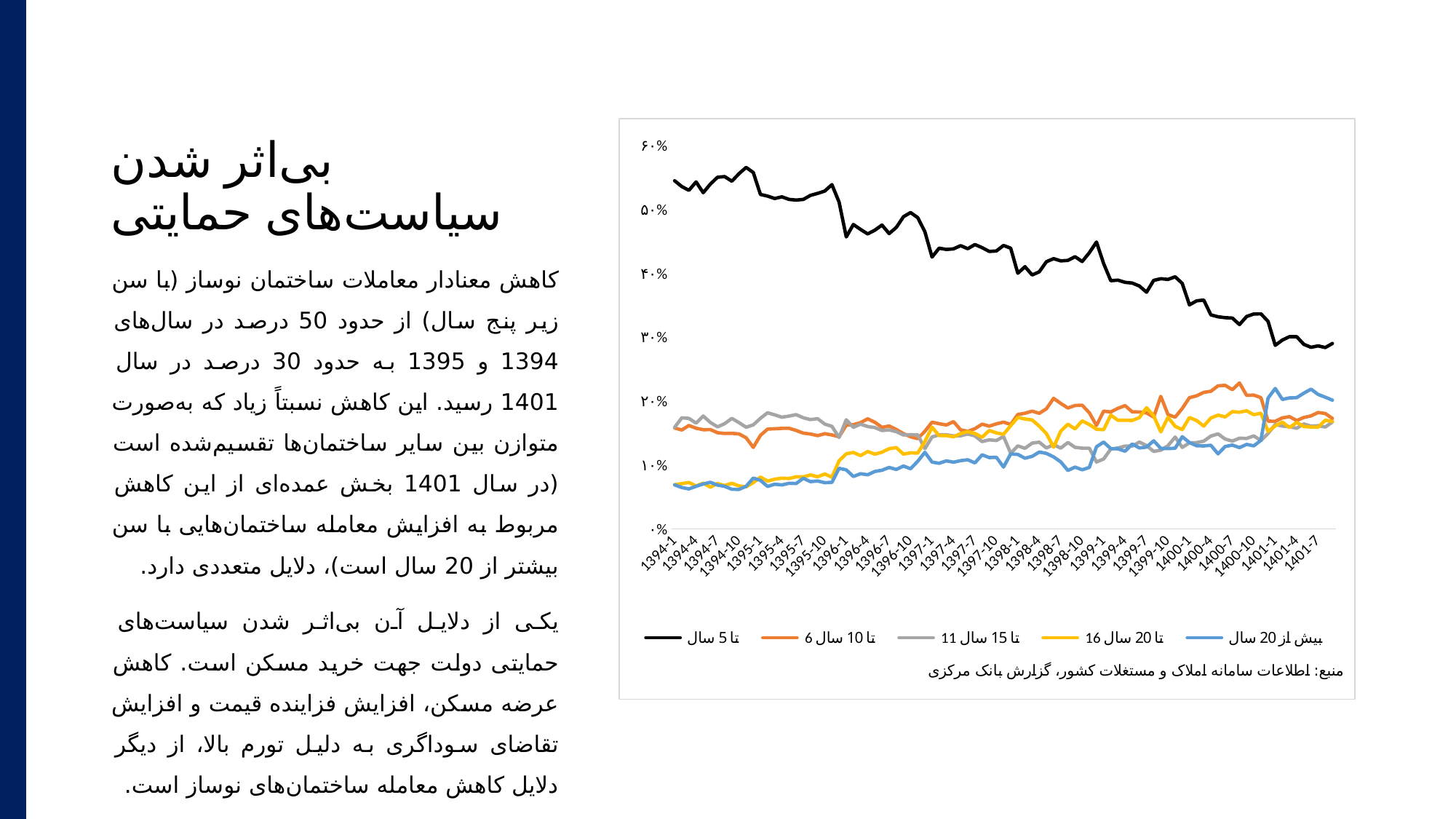
What colour is the line for the تا 5 سال series? Black What is the highest tick value shown on the chart's vertical axis? ۶۰% At 1394-1, which series has the larger value: تا 5 سال or بیش از 20 سال? تا 5 سال How many series does the chart's legend list? 5 Which series has the highest values across the whole chart? تا 5 سال Is the value of the تا 5 سال series at 1401-7 greater or less than 30%? less Is the value of the بیش از 20 سال series at 1394-1 greater or less than 10%? less Does the value of the بیش از 20 سال series rise or fall from 1394-1 to 1401-7? Rise Is the value of the تا 5 سال series at 1394-1 greater or less than 50%? greater What kind of chart is shown on the slide? Line chart Does the value of the تا 5 سال series rise or fall from 1394-1 to 1401-7? Fall